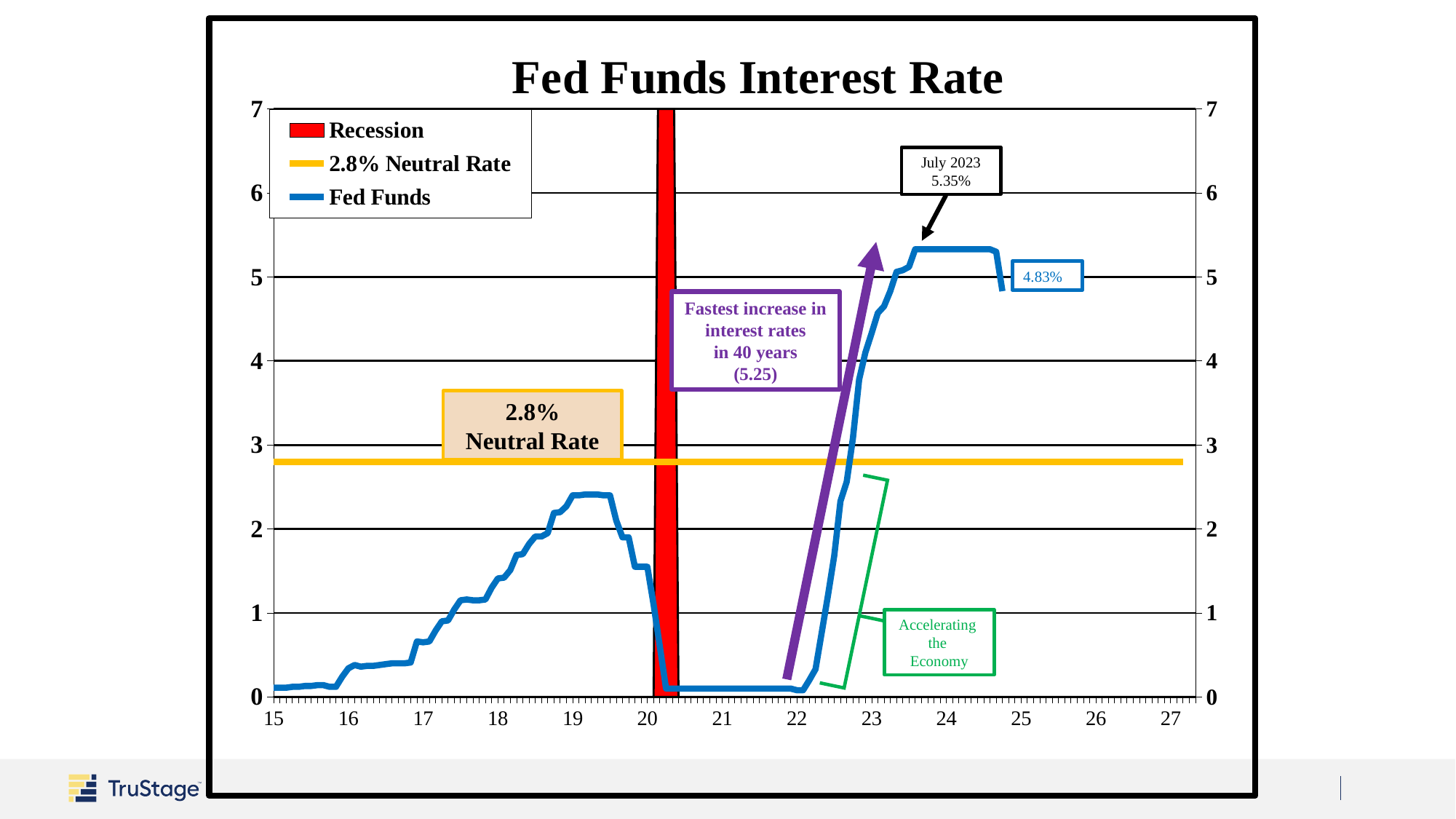
Which is larger, the July 2023 Fed Funds rate or the neutral rate? July 2023 Fed Funds rate (5.35%) How many entries does the legend list? 3 Is the Fed Funds rate during 2021 greater or less than 1? less What colour is the Fed Funds line? Blue What is the value of the neutral rate shown by the yellow line? 2.8% What kind of chart is used to show the Fed Funds rate? Line chart Is the Fed Funds rate at its 2019 peak greater or less than 3? less What Fed Funds value is labeled at the end of the blue line, after 2024? 4.83% What is the title of the chart? Fed Funds Interest Rate Does the Fed Funds rate rise or fall between 2022 and 2023? rise What Fed Funds rate is labeled for July 2023? 5.35%